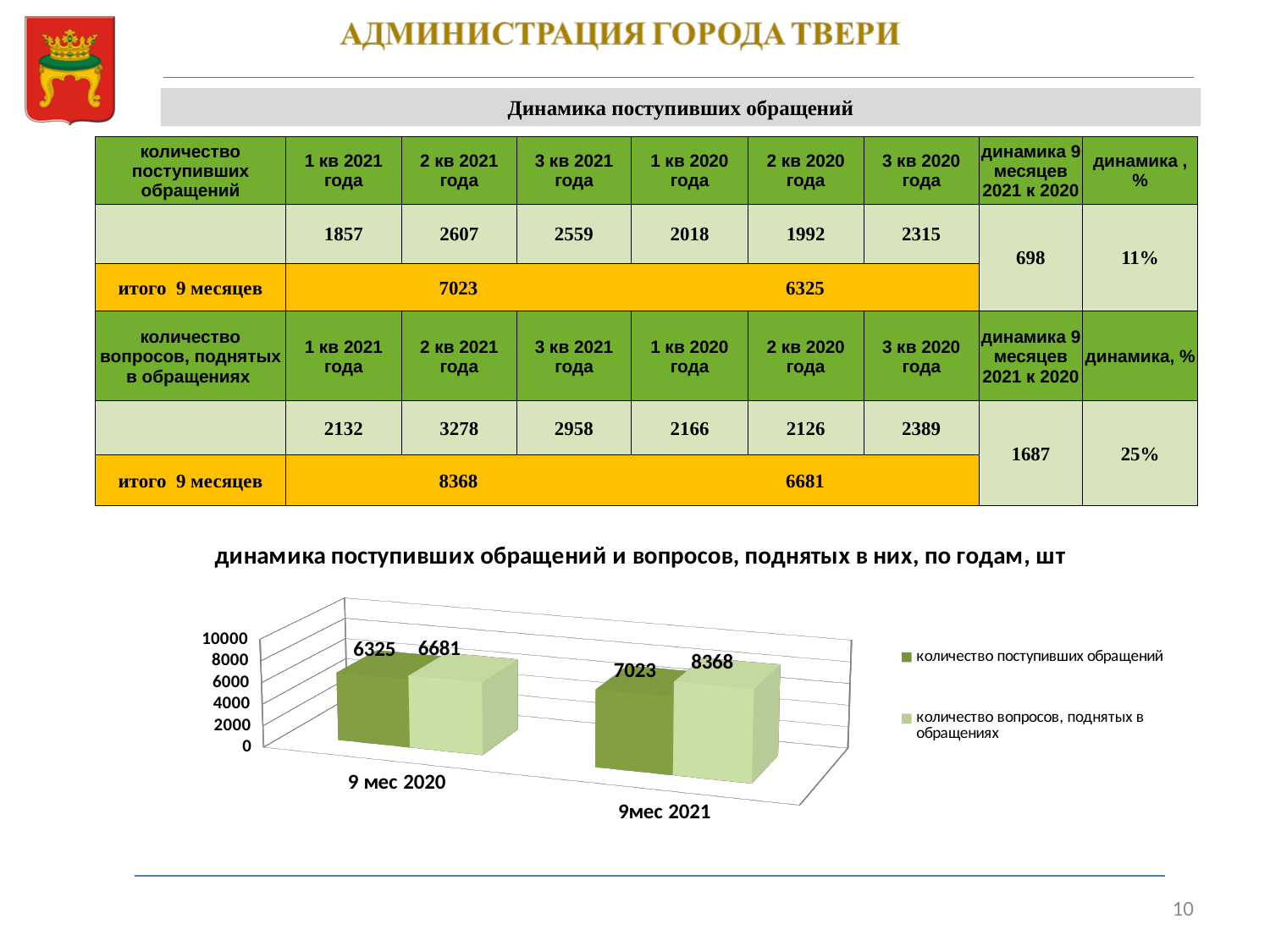
What is the value of 'количество вопросов, поднятых в обращениях' for '9 мес 2020'? 6681 What is the difference between 'количество вопросов, поднятых в обращениях' and 'количество поступивших обращений' for '9мес 2021'? 1345 How many categories are shown on the x axis of the chart? 2 What is the difference in 'количество поступивших обращений' between '9мес 2021' and '9 мес 2020'? 698 Which category has the highest value for 'количество вопросов, поднятых в обращениях'? 9мес 2021 What type of chart is shown on the slide? bar chart What is the title of the chart? динамика поступивших обращений и вопросов, поднятых в них, по годам, шт Which is larger: 'количество поступивших обращений' for '9мес 2021' or 'количество вопросов, поднятых в обращениях' for '9 мес 2020'? количество поступивших обращений for 9мес 2021 What is the value of 'количество поступивших обращений' for '9 мес 2020'? 6325 What is the value of 'количество поступивших обращений' for '9мес 2021'? 7023 What is the value of 'количество вопросов, поднятых в обращениях' for '9мес 2021'? 8368 How many series does the chart legend list? 2